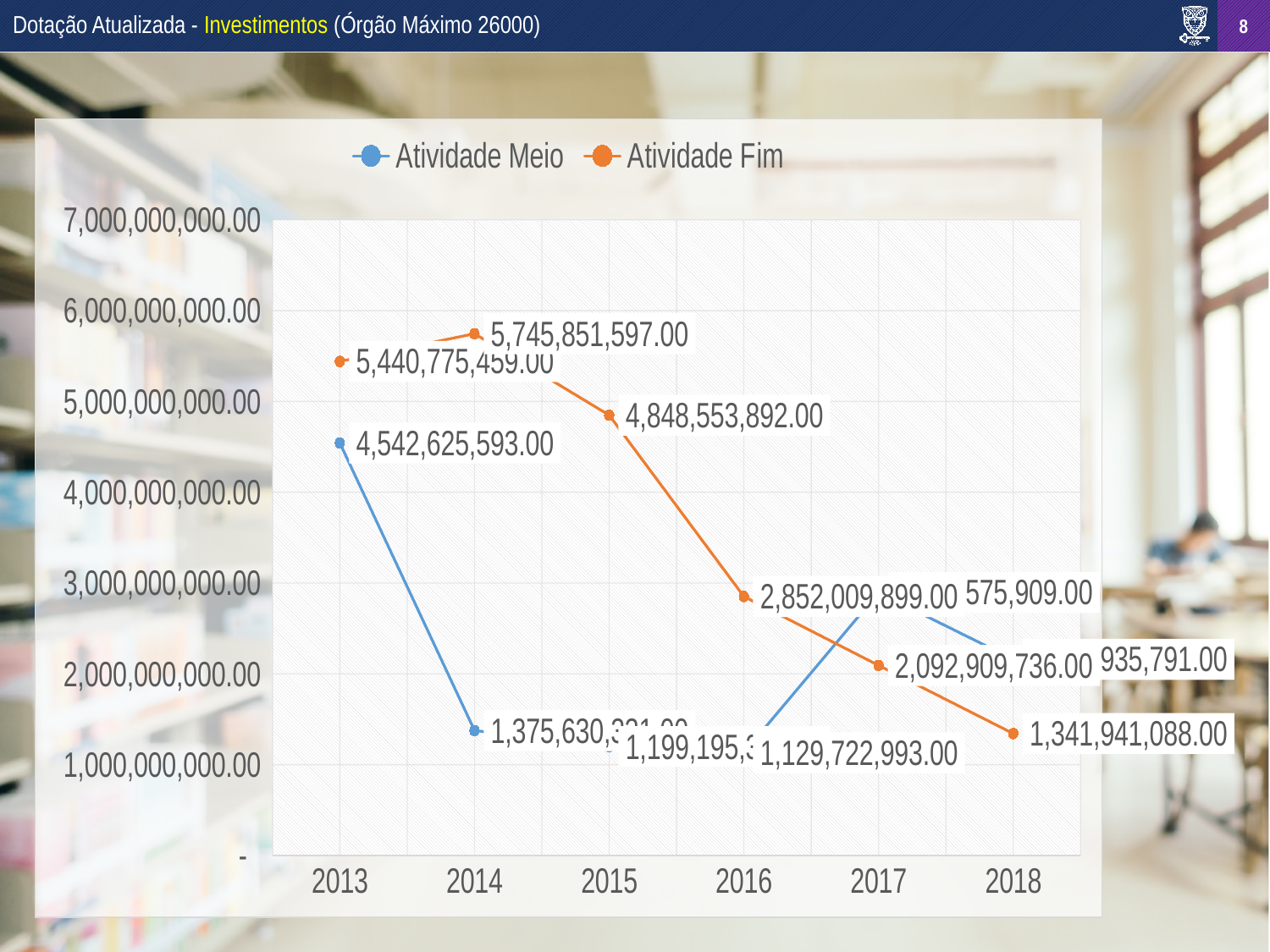
In which year is Atividade Fim highest? 2014 How many series does the legend list? 2 What is the difference between Atividade Fim in 2014 and in 2015? 897,297,705.00 How many years are shown on the x axis? 6 What is the value of Atividade Fim in 2014? 5,745,851,597.00 What is the value of Atividade Meio in 2016? 1,129,722,993.00 What kind of chart is shown on the slide? line chart What is the value of Atividade Meio in 2013? 4,542,625,593.00 What is the value of Atividade Fim in 2015? 4,848,553,892.00 In 2013, which series has the larger value, Atividade Meio or Atividade Fim? Atividade Fim What is the value of Atividade Fim in 2018? 1,341,941,088.00 In which year is Atividade Fim lowest? 2018